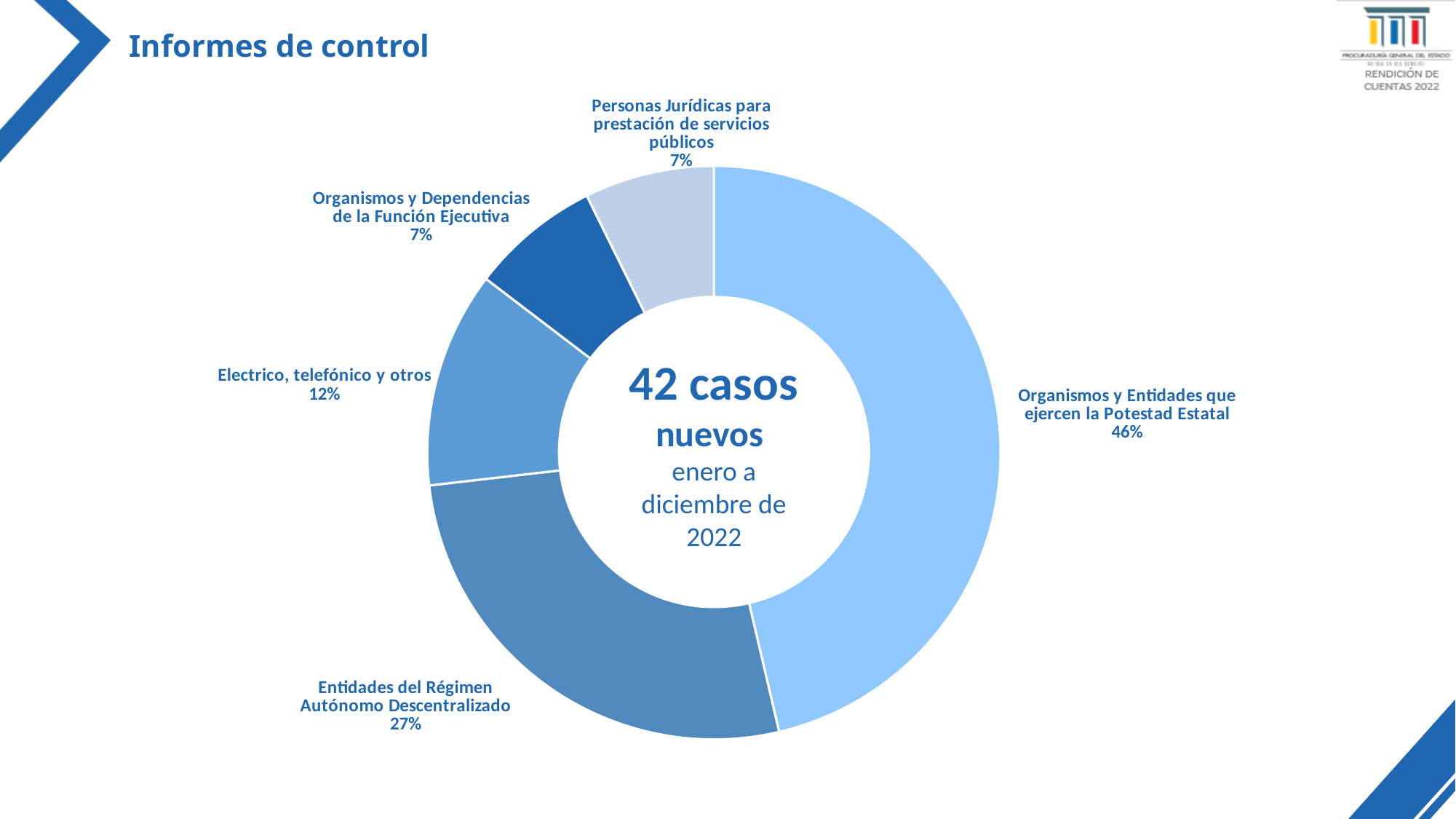
How many categories does the pie chart show? 5 What percentage is shown for "Entidades del Régimen Autónomo Descentralizado"? 27% What percentage is shown for "Organismos y Dependencias de la Función Ejecutiva"? 7% How many new cases does the text in the centre of the chart report? 42 casos What kind of chart is shown on the slide? Pie chart (donut) What share of the pie does "Organismos y Entidades que ejercen la Potestad Estatal" represent? 46% Which is larger: the share for "Electrico, telefónico y otros" or the share for "Personas Jurídicas para prestación de servicios públicos"? Electrico, telefónico y otros What is the difference in percentage points between "Entidades del Régimen Autónomo Descentralizado" and "Electrico, telefónico y otros"? 15 percentage points What is the difference in percentage points between "Organismos y Entidades que ejercen la Potestad Estatal" and "Entidades del Régimen Autónomo Descentralizado"? 19 percentage points What is the title of the slide containing the chart? Informes de control What percentage is shown for "Electrico, telefónico y otros"? 12% Which category has the largest share of the pie? Organismos y Entidades que ejercen la Potestad Estatal